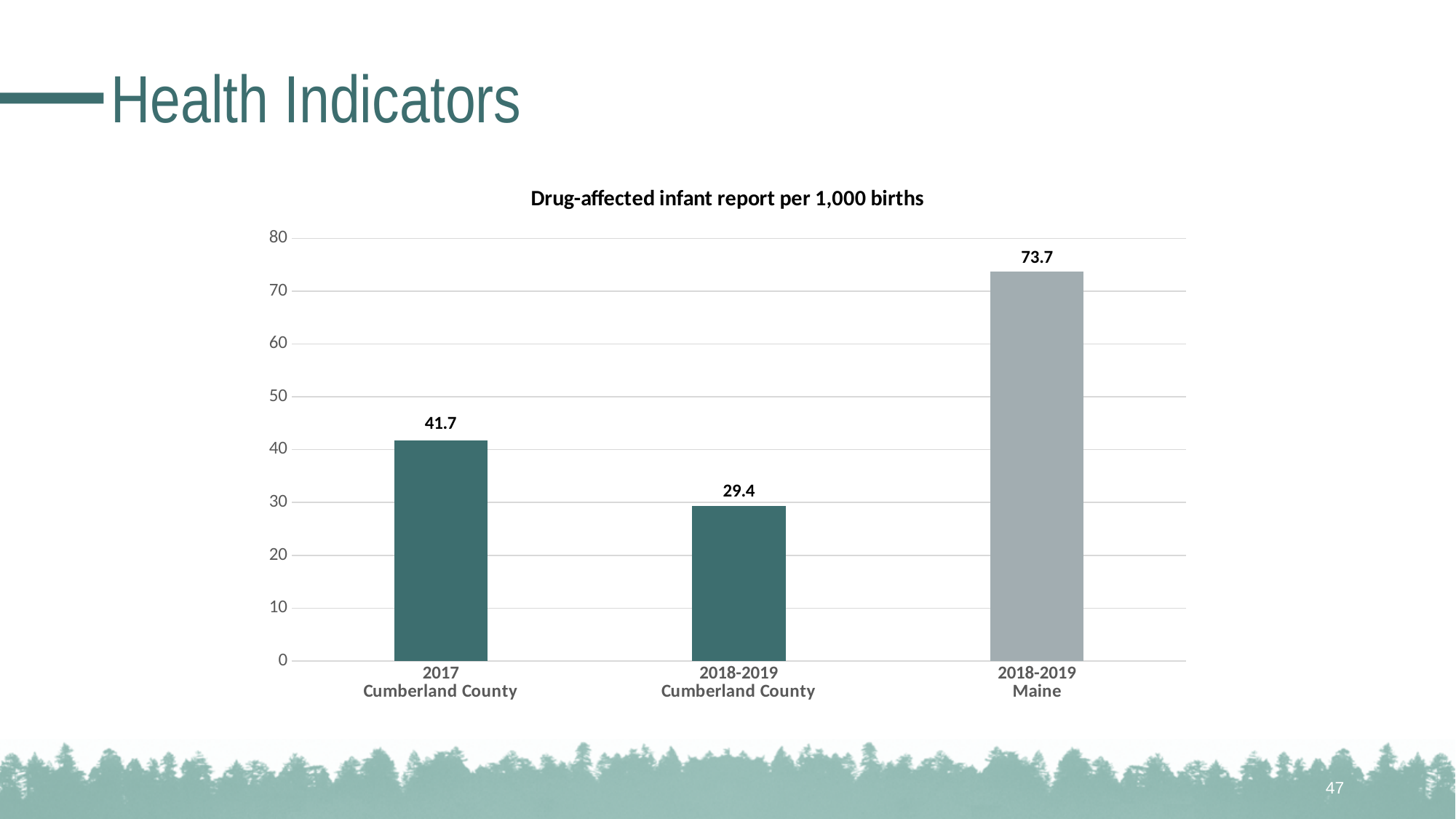
What kind of chart is shown on the slide? bar chart What is the difference between the 2018-2019 Maine value and the 2018-2019 Cumberland County value? 44.3 What is the value for 2017 Cumberland County? 41.7 What is the title of the chart? Drug-affected infant report per 1,000 births Which category has the lowest value? 2018-2019 Cumberland County Which is larger, the value for 2017 Cumberland County or the value for 2018-2019 Cumberland County? 2017 Cumberland County What is the value for 2018-2019 Maine? 73.7 What is the difference between the 2017 Cumberland County value and the 2018-2019 Cumberland County value? 12.3 How many bars are shown in the chart? 3 Which category has the highest value? 2018-2019 Maine Is the value for 2018-2019 Maine greater or less than 70? greater What is the value for 2018-2019 Cumberland County? 29.4